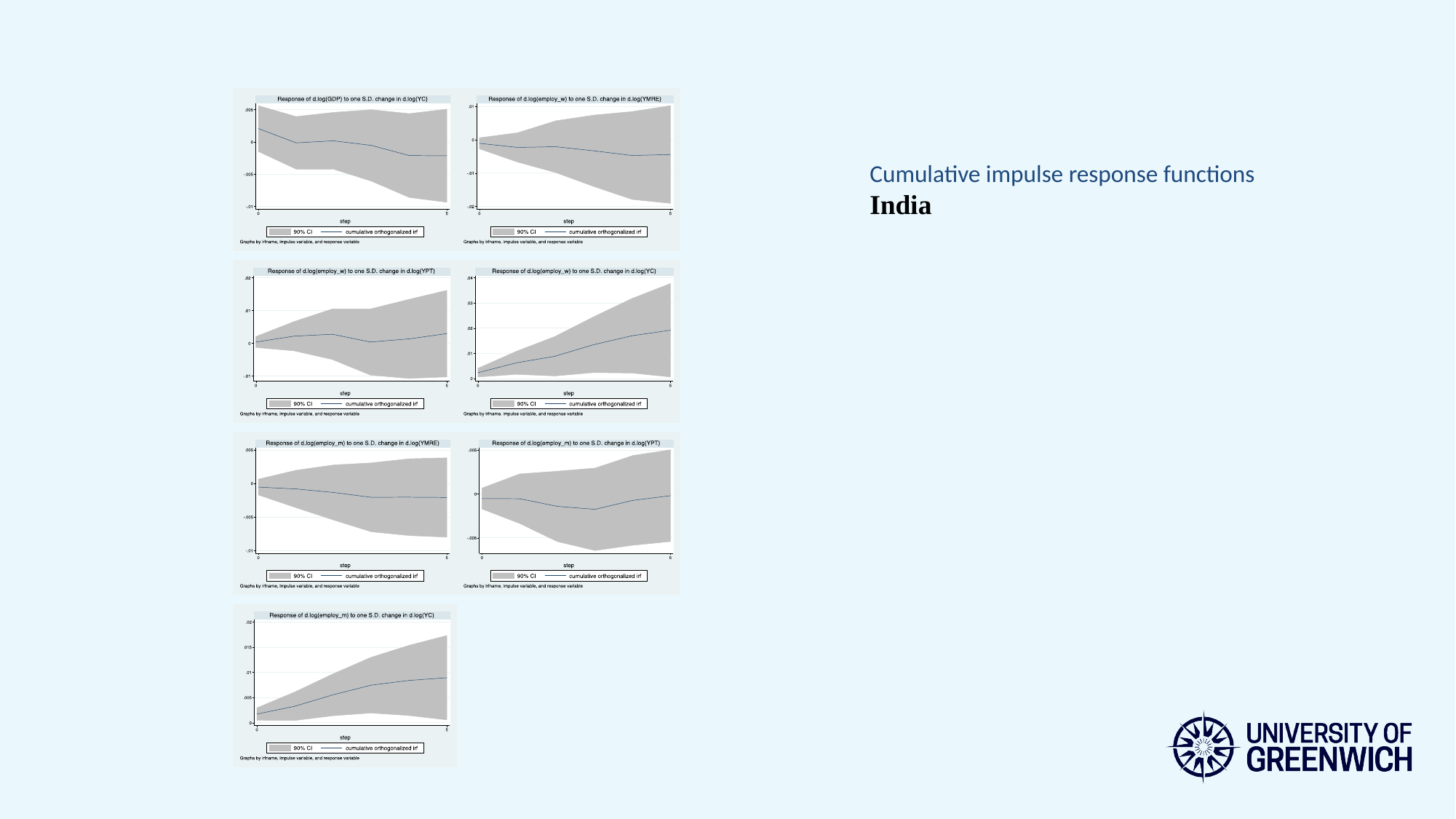
What are the two legend entries shown in the chart 'Response of d.log(employ_m) to one S.D. change in d.log(YPT)'? 90% CI and cumulative orthogonalized irf In the chart 'Response of d.log(employ_m) to one S.D. change in d.log(YC)', is the cumulative orthogonalized irf value at step 5 greater or less than .005? greater In the chart 'Response of d.log(employ_m) to one S.D. change in d.log(YC)', does the cumulative orthogonalized irf line rise or fall from step 0 to step 5? Rise What is the x-axis label on the chart 'Response of d.log(GDP) to one S.D. change in d.log(YC)'? step In the chart 'Response of d.log(employ_w) to one S.D. change in d.log(YC)', does the cumulative orthogonalized irf line rise or fall as step increases? Rise In the chart 'Response of d.log(employ_w) to one S.D. change in d.log(YC)', is the cumulative orthogonalized irf value at step 5 greater or less than .01? greater In the chart 'Response of d.log(employ_m) to one S.D. change in d.log(YMRE)', is the cumulative orthogonalized irf value at step 5 greater or less than 0? less How many charts are shown on the slide? 7 How many entries does the legend list in the chart 'Response of d.log(employ_w) to one S.D. change in d.log(YC)'? 2 What kind of chart is the top-left chart, 'Response of d.log(GDP) to one S.D. change in d.log(YC)'? Line chart In the chart 'Response of d.log(employ_w) to one S.D. change in d.log(YC)', is the cumulative orthogonalized irf value at step 5 larger or smaller than the value at step 0? Larger In the chart 'Response of d.log(employ_w) to one S.D. change in d.log(YMRE)', does the cumulative orthogonalized irf line rise or fall from step 0 to step 5? Fall